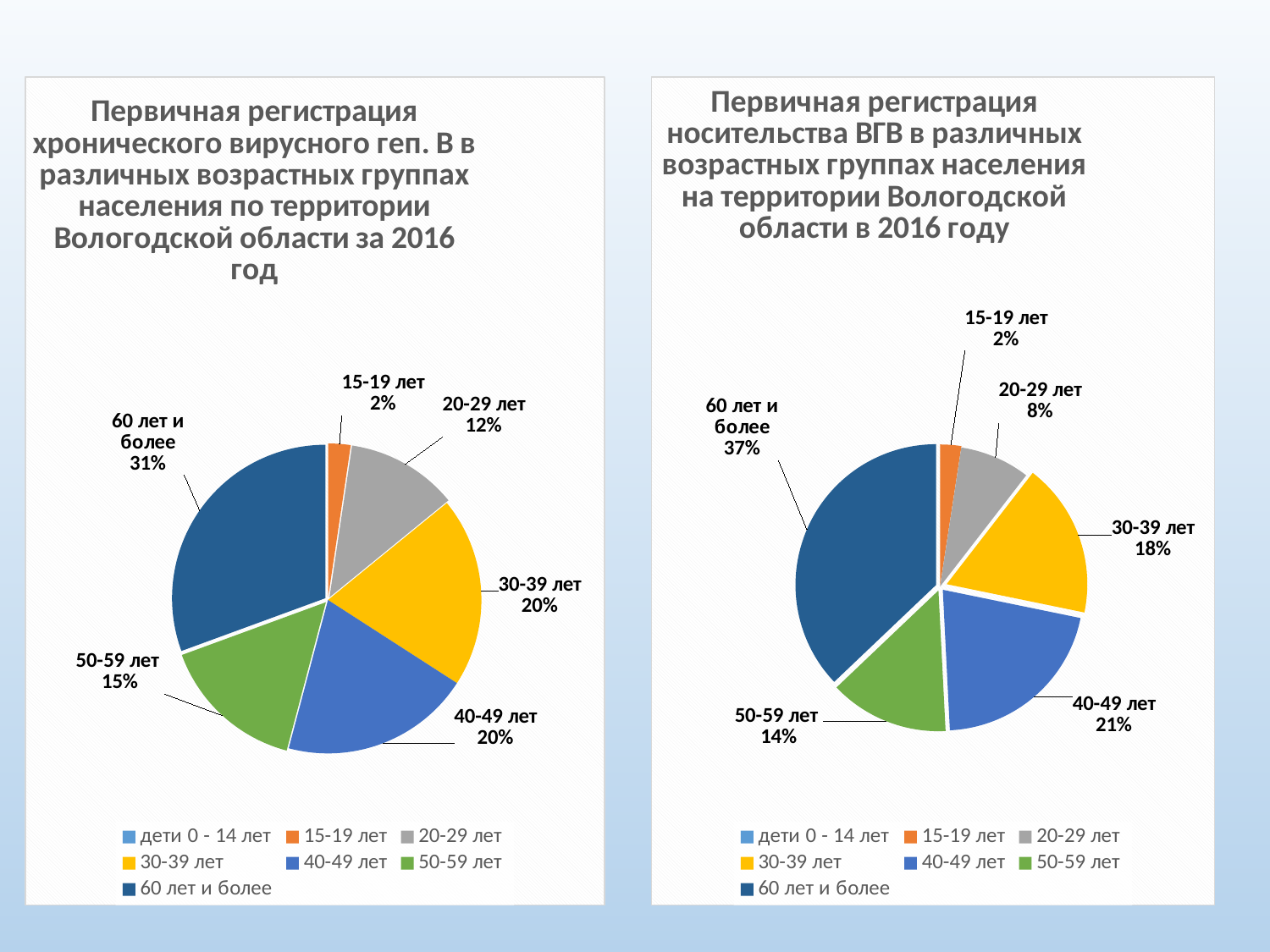
On the left pie chart, what colour is the slice for 30-39 лет? yellow On the right pie chart, what share is shown for the 20-29 лет group? 8% On the left pie chart, what share is shown for the 60 лет и более group? 31% On the right pie chart, what is the difference in percentage points between the 60 лет и более share and the 50-59 лет share? 23 What type of chart is used on the right side of the slide? pie chart On the left pie chart, what is the difference in percentage points between the 30-39 лет share and the 20-29 лет share? 8 How many series does the legend of the left chart list? 7 Which chart shows a larger share for the 60 лет и более group, the left or the right? the right On the left pie chart, which is larger: the share for 50-59 лет or the share for 20-29 лет? 50-59 лет On the right pie chart, which labelled age group has the smallest share? 15-19 лет On the right pie chart, what share is shown for the 40-49 лет group? 21% On the left pie chart, which age group has the largest share? 60 лет и более